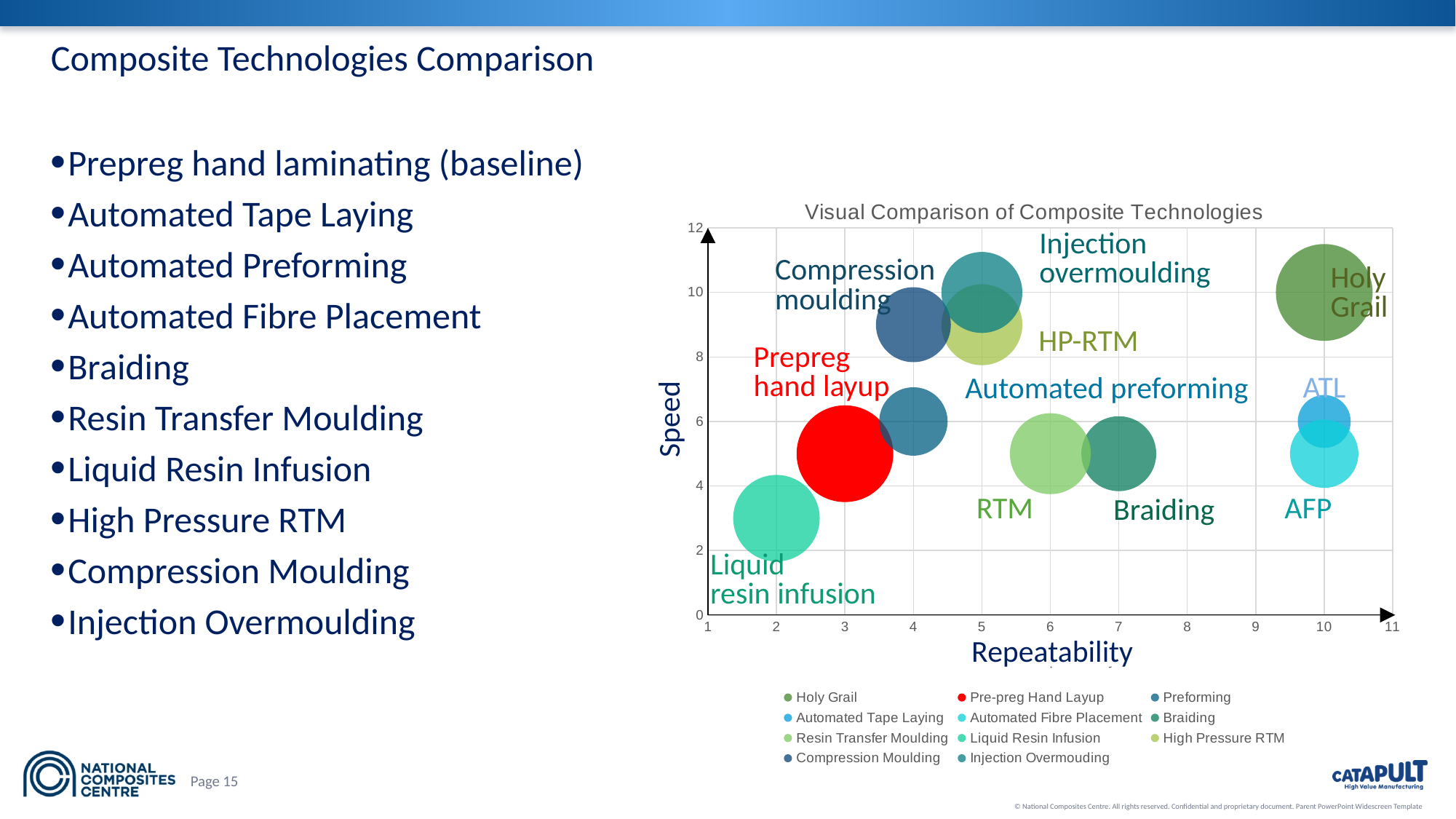
Is the Speed value for Holy Grail greater or less than 8? greater Is the Speed value for Liquid resin infusion greater or less than 4? less What is the title of the chart? Visual Comparison of Composite Technologies Which technology has the lowest Repeatability value in the chart? Liquid resin infusion How many series does the chart legend list? 11 Which has the higher Speed value, Holy Grail or Prepreg hand layup? Holy Grail Which technology has the lowest Speed value in the chart? Liquid resin infusion Which has the higher Repeatability value, Braiding or Liquid resin infusion? Braiding What kind of chart is shown on the slide? Bubble chart Is the Repeatability value for ATL greater or less than 8? greater What is the label of the vertical axis of the chart? Speed